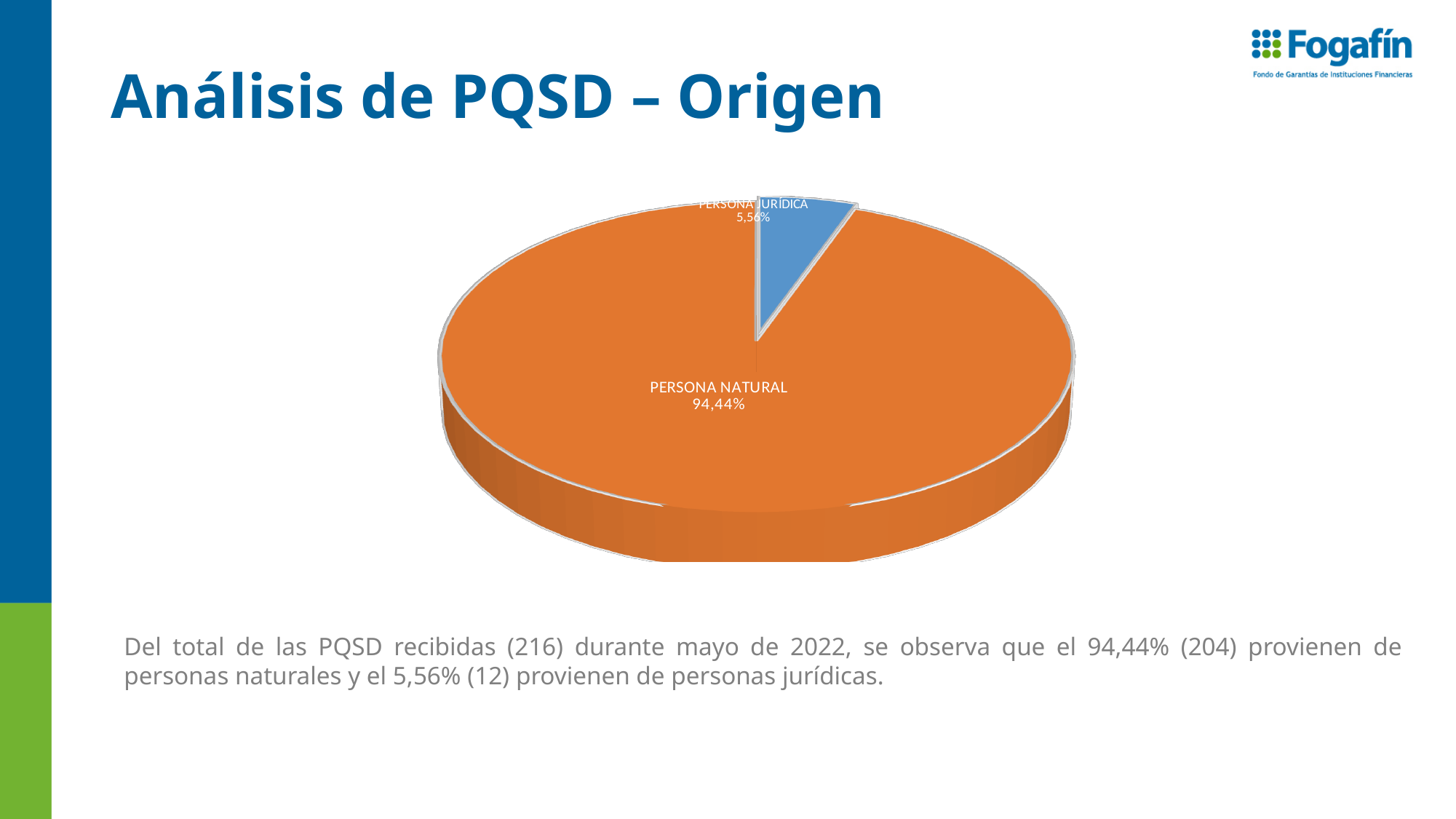
What colour is the PERSONA JURÍDICA slice? blue What kind of chart is shown on the slide? pie chart What share of the pie does PERSONA NATURAL represent? 94,44% What is the difference in percentage points between PERSONA NATURAL and PERSONA JURÍDICA? 88,88 What colour is the PERSONA NATURAL slice? orange Which is larger, the slice for PERSONA NATURAL or the slice for PERSONA JURÍDICA? PERSONA NATURAL How many slices does the pie chart have? 2 What share of the pie does PERSONA JURÍDICA represent? 5,56% Which category has the largest slice of the pie? PERSONA NATURAL Which category has the smallest slice of the pie? PERSONA JURÍDICA